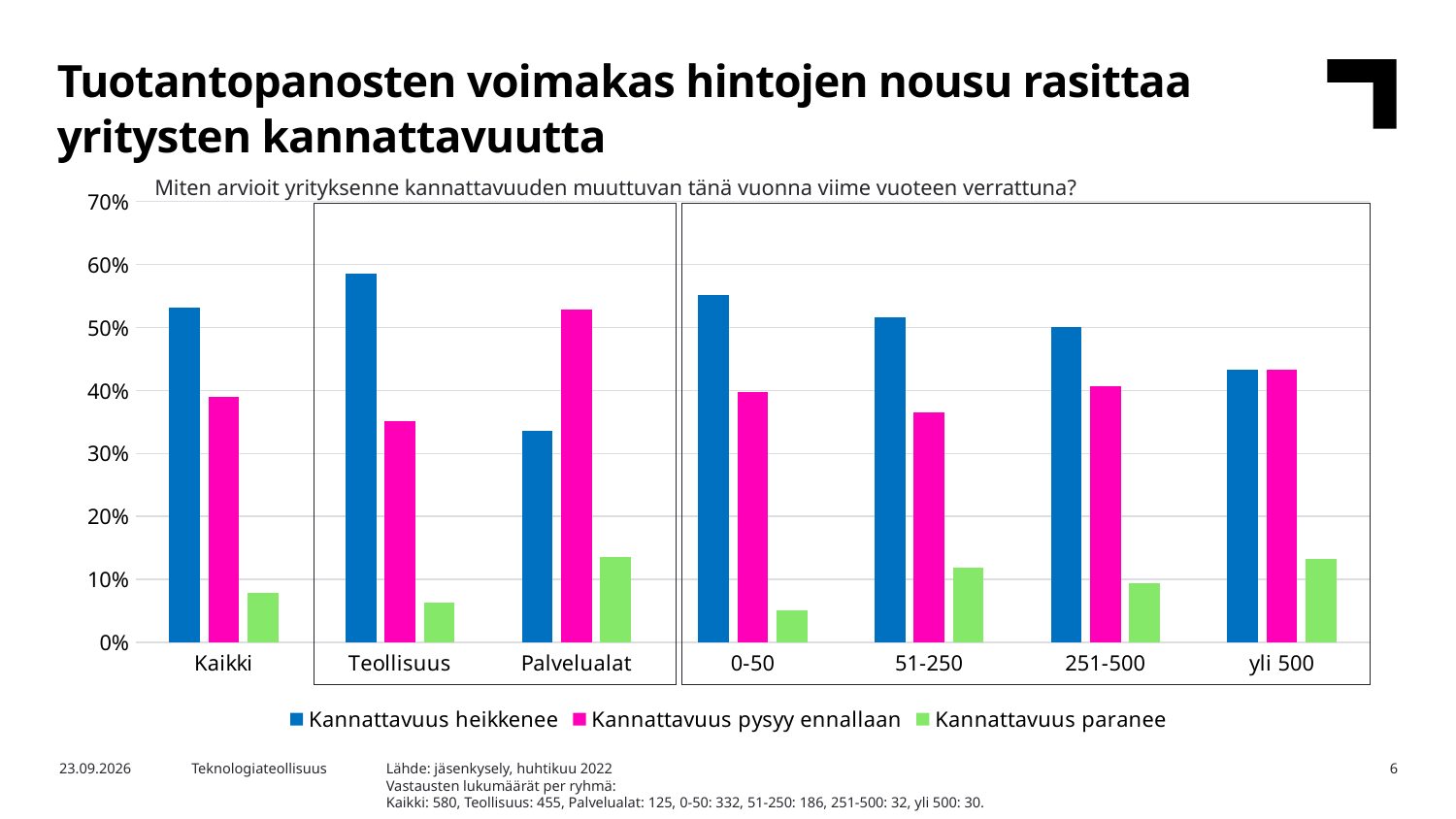
Is the value of Kannattavuus heikkenee for Teollisuus greater or less than 50%? greater Which colour represents Kannattavuus paranee in the legend? green Which category has the lowest value for Kannattavuus heikkenee? Palvelualat Is the value of Kannattavuus paranee for Palvelualat greater or less than 10%? greater Is the value of Kannattavuus pysyy ennallaan for 51-250 greater or less than 40%? less What kind of chart is shown on the slide? bar chart How many categories are shown on the x axis? 7 For Palvelualat, which is larger: Kannattavuus heikkenee or Kannattavuus pysyy ennallaan? Kannattavuus pysyy ennallaan Which category has the highest value for Kannattavuus pysyy ennallaan? Palvelualat Which category has the highest value for Kannattavuus heikkenee? Teollisuus How many series does the legend list? 3